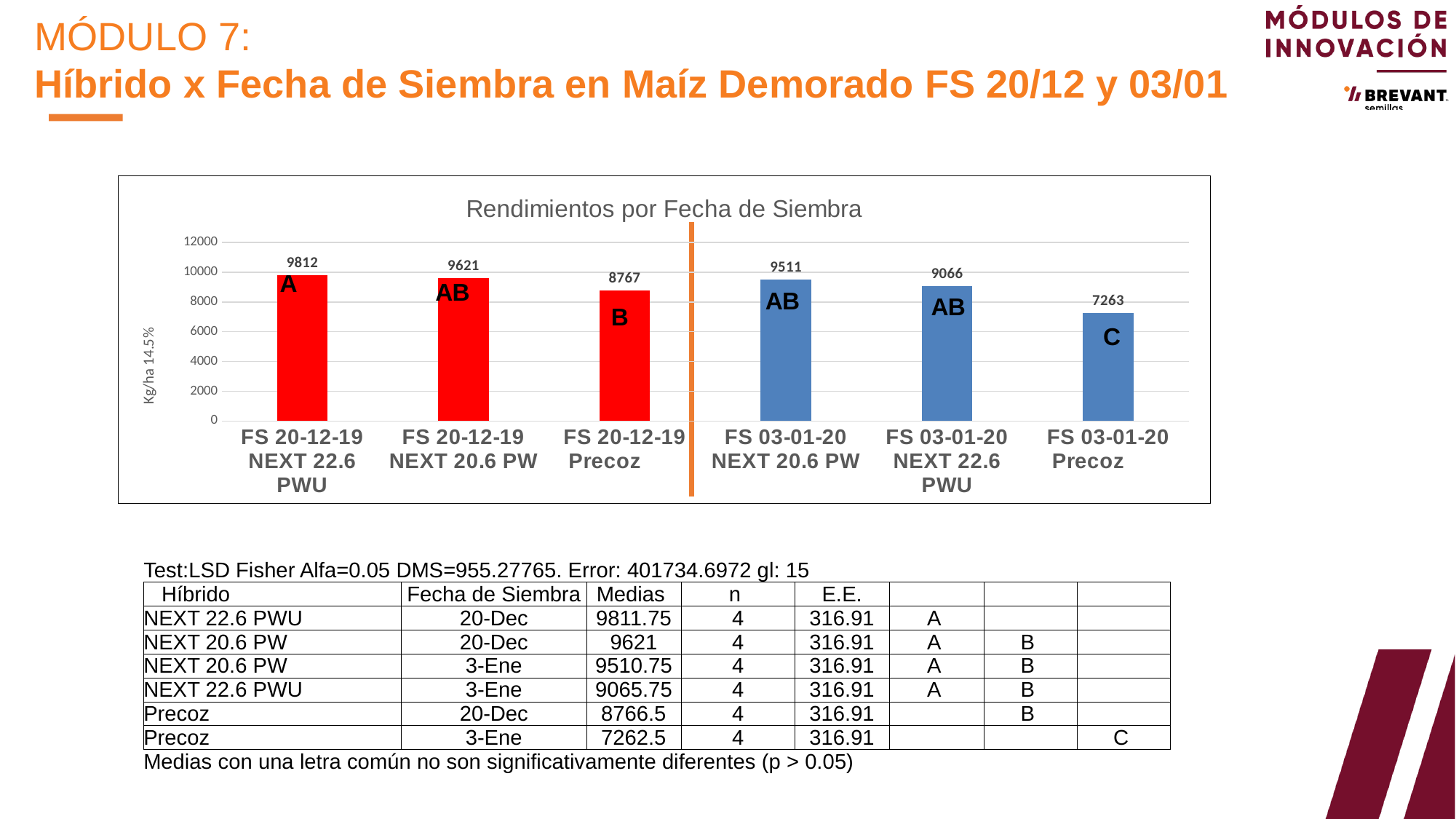
Which category has the highest value? FS 20-12-19 NEXT 22.6 PWU What is the value for FS 20-12-19 NEXT 22.6 PWU? 9812 What kind of chart is shown? bar chart Is the value for FS 03-01-20 NEXT 22.6 PWU greater or less than 8000? greater Which is larger, FS 20-12-19 NEXT 20.6 PW or FS 03-01-20 NEXT 22.6 PWU? FS 20-12-19 NEXT 20.6 PW What is the y-axis label of the chart? Kg/ha 14.5% What is the difference between FS 20-12-19 Precoz and FS 03-01-20 Precoz? 1504 How many bars are shown in the chart? 6 What is the value for FS 03-01-20 Precoz? 7263 What is the title of the chart? Rendimientos por Fecha de Siembra What is the value for FS 03-01-20 NEXT 20.6 PW? 9511 Which category has the lowest value? FS 03-01-20 Precoz